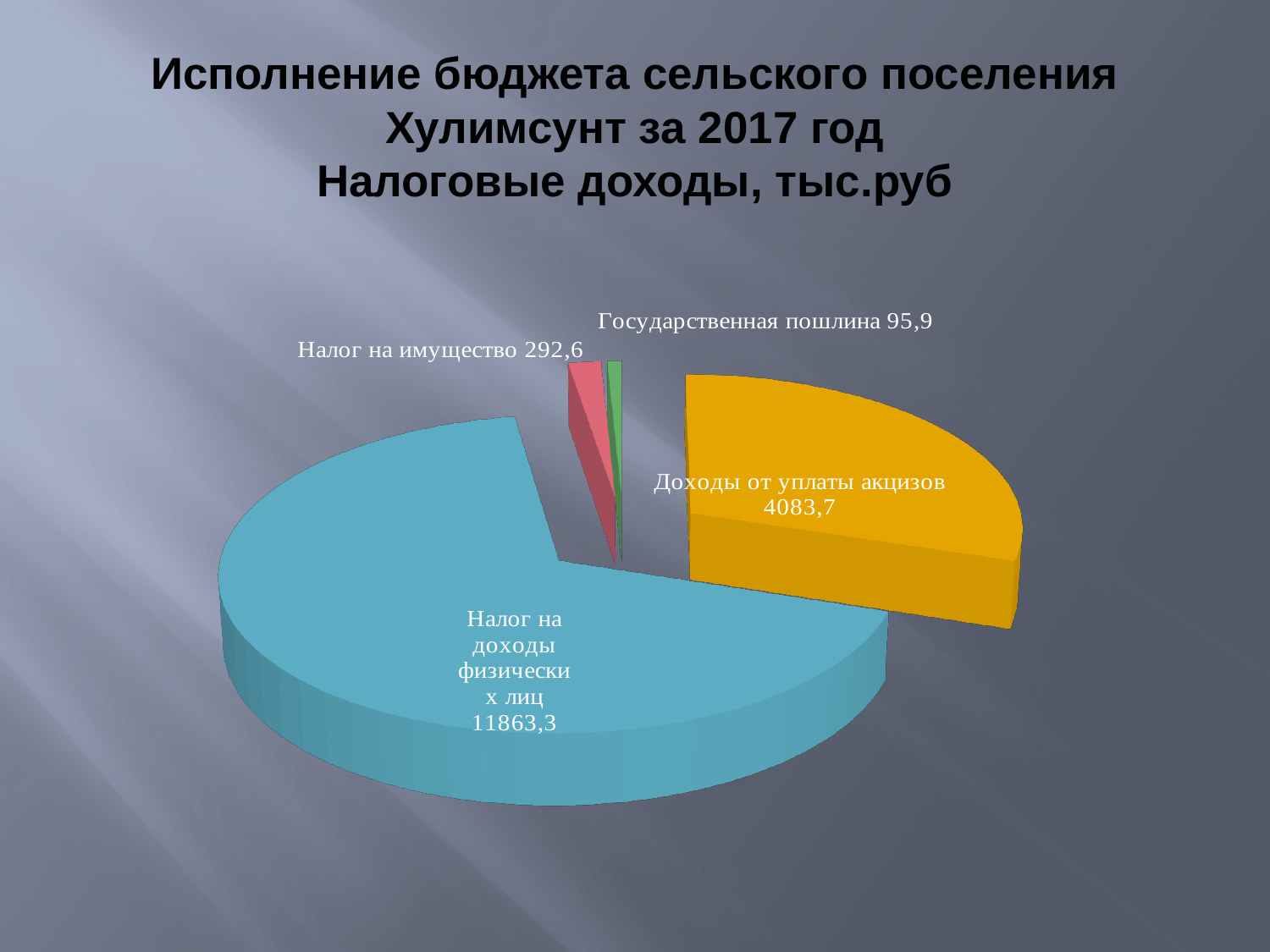
What type of chart is shown on the slide? Pie chart What is the total of all slices in the pie chart? 16335,5 What is the difference between Налог на доходы физических лиц and Доходы от уплаты акцизов? 7779,6 Which is larger, Налог на имущество or Государственная пошлина? Налог на имущество How many slices does the pie chart have? 4 What is the value for Налог на доходы физических лиц? 11863,3 Which category has the largest slice of the pie? Налог на доходы физических лиц What is the value for Доходы от уплаты акцизов? 4083,7 What is the value for Государственная пошлина? 95,9 Which category has the smallest slice of the pie? Государственная пошлина What is the value for Налог на имущество? 292,6 In what units are the values on the chart given, according to the title? тыс.руб